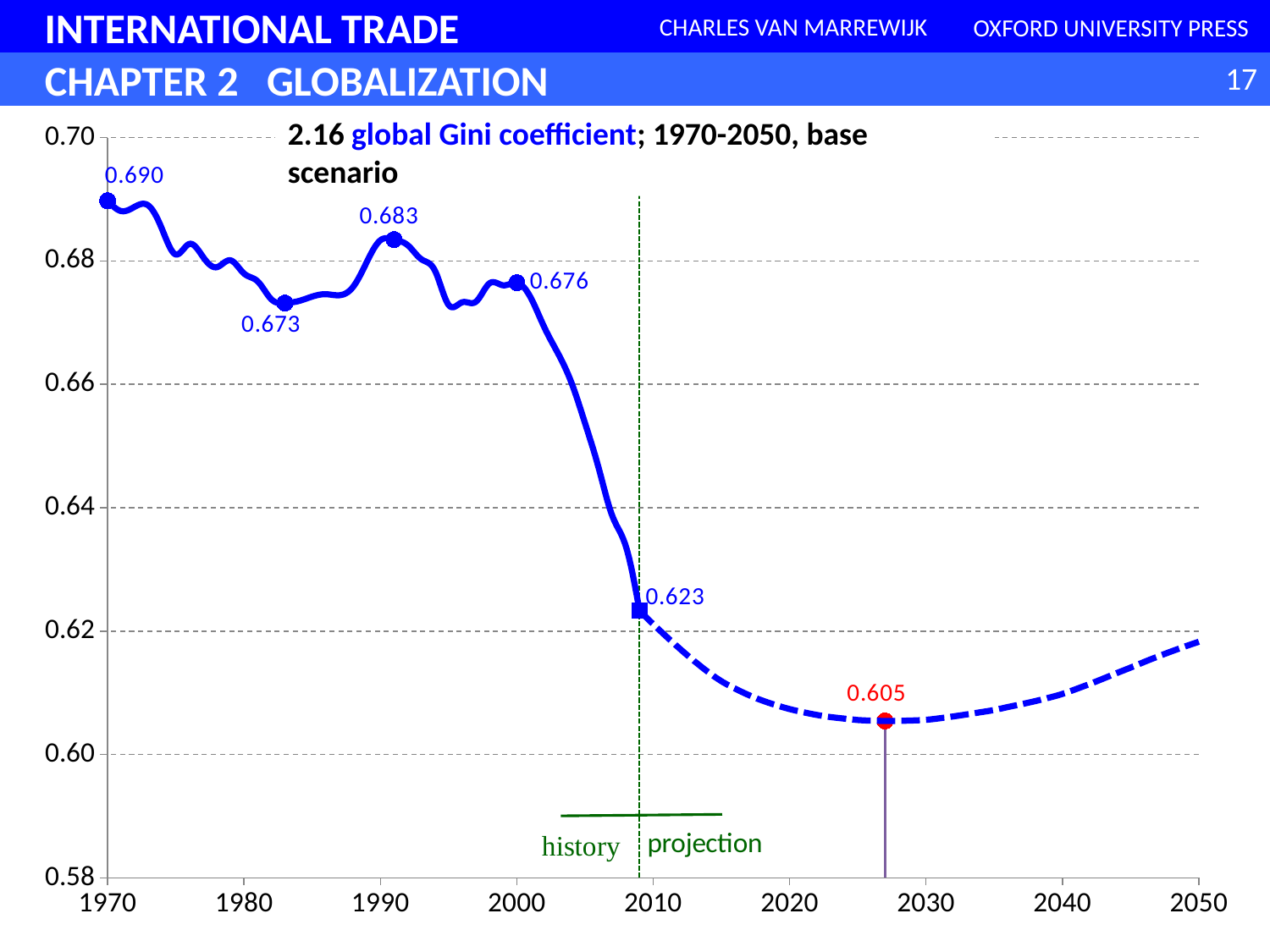
What is the highest labelled value on the chart? 0.690 What is the global Gini coefficient labelled for 2000? 0.676 What is the global Gini coefficient labelled for 1970? 0.690 Which is larger, the labelled value 0.683 or the labelled value 0.673? 0.683 What two periods does the dashed vertical line on the chart separate? history and projection Is the value of the global Gini coefficient in 2020 greater or less than 0.62? less What is the difference between the labelled values 0.676 and 0.623? 0.053 Does the global Gini coefficient rise or fall between 2000 and 2010? fall How many data points are labelled with values on the chart? 6 What is the lowest labelled value on the chart? 0.605 What kind of chart is shown on the slide? line chart What is the difference between the labelled values 0.690 and 0.676? 0.014